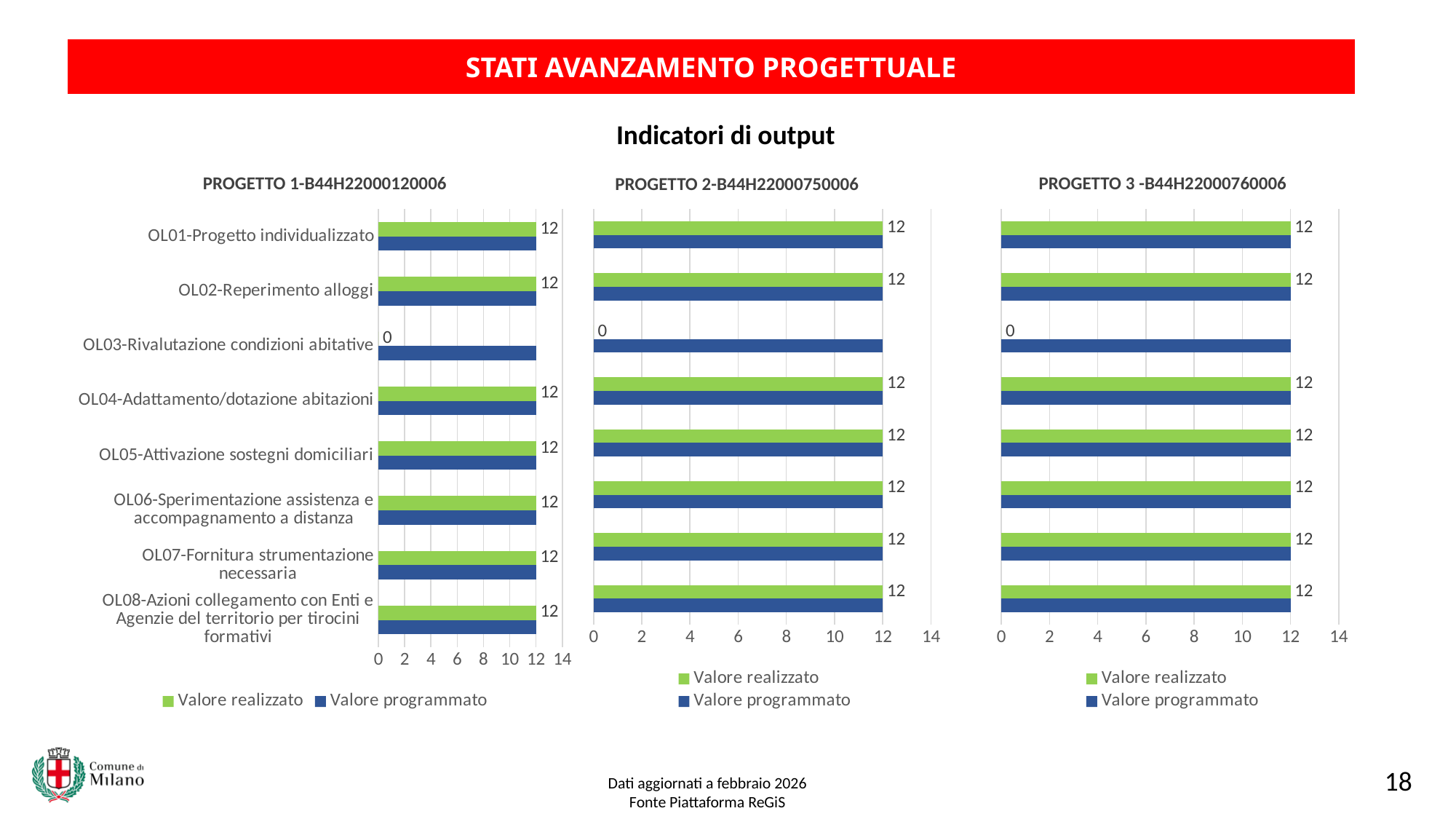
In the PROGETTO 1-B44H22000120006 chart, which category has the lowest Valore realizzato? OL03-Rivalutazione condizioni abitative How many series does the legend of the PROGETTO 3 -B44H22000760006 chart list? 2 What kind of chart is the PROGETTO 1-B44H22000120006 chart? Bar chart How many categories are shown in the PROGETTO 2-B44H22000750006 chart? 8 Which colour represents Valore realizzato in the PROGETTO 1-B44H22000120006 chart? Green In the PROGETTO 1-B44H22000120006 chart, what is the Valore realizzato for OL03-Rivalutazione condizioni abitative? 0 What is the maximum value shown on the x axis of the PROGETTO 2-B44H22000750006 chart? 14 In the PROGETTO 3 -B44H22000760006 chart, which is larger for OL03-Rivalutazione condizioni abitative: Valore realizzato or Valore programmato? Valore programmato In the PROGETTO 3 -B44H22000760006 chart, what is the Valore realizzato for OL08-Azioni collegamento con Enti e Agenzie del territorio per tirocini formativi? 12 In the PROGETTO 1-B44H22000120006 chart, is the Valore programmato for OL01-Progetto individualizzato greater or less than 10? greater In the PROGETTO 2-B44H22000750006 chart, what is the difference between the Valore programmato and the Valore realizzato for OL03-Rivalutazione condizioni abitative? 12 In the PROGETTO 2-B44H22000750006 chart, what is the Valore realizzato for OL05-Attivazione sostegni domiciliari? 12